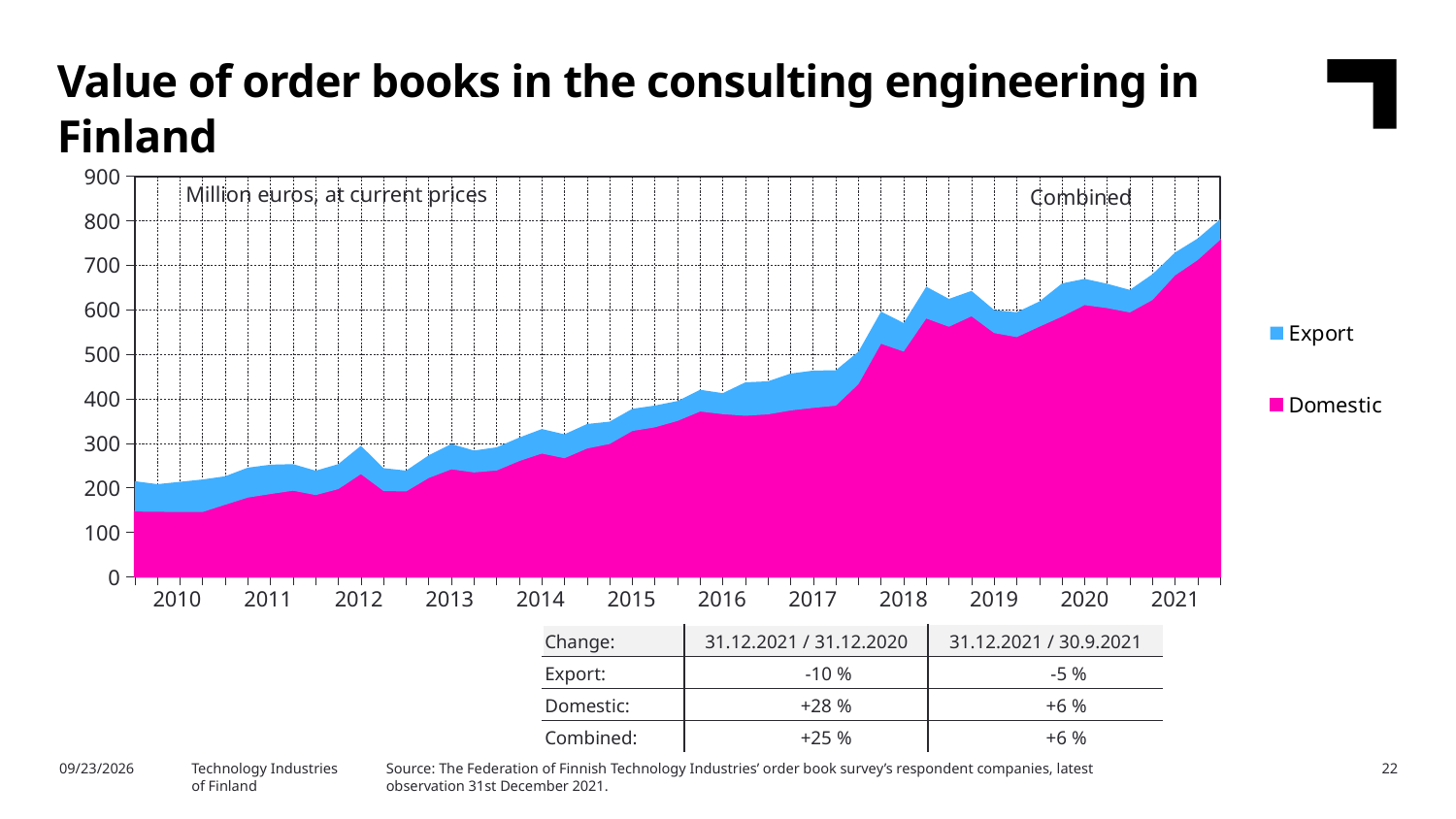
What is the highest value shown on the y axis? 900 What unit is stated for the values in the chart? Million euros, at current prices Is the Domestic value at the start of 2010 greater or less than 200? less What kind of chart is shown on the slide? Area chart How many series does the legend list? 2 Is the combined value at the start of 2014 greater or less than 400? less Does the combined value of order books generally rise or fall from 2010 to 2021? Rise How many years are labelled on the x axis? 12 Which series is larger throughout the period, Export or Domestic? Domestic Is the Domestic value at the end of 2021 greater or less than 600? greater Which two series are listed in the legend? Export and Domestic